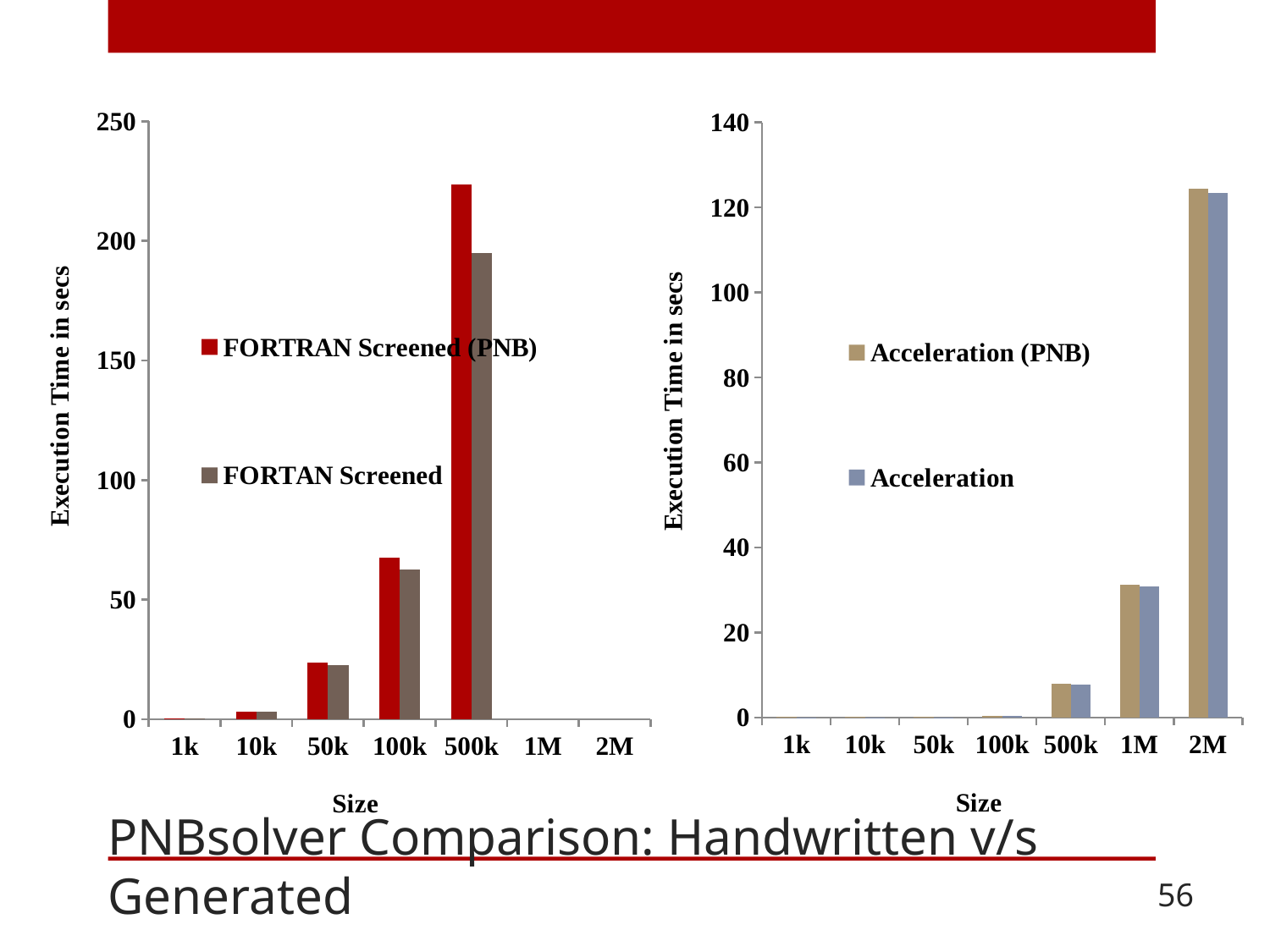
In the left chart, is the value for FORTAN Screened at size 500k greater or less than 150? greater In the left chart, which size has the highest execution time for FORTRAN Screened (PNB)? 500k How many size categories are shown on the x axis of the left chart? 7 What kind of chart is the left chart (FORTRAN Screened)? bar chart In the right chart, is the value for Acceleration (PNB) at size 2M greater or less than 120? greater In the right chart, which size has the highest execution time for Acceleration? 2M What is the y-axis label of the right chart? Execution Time in secs In the left chart, at size 500k, which series has the larger value: FORTRAN Screened (PNB) or FORTAN Screened? FORTRAN Screened (PNB) In the right chart, is the value for Acceleration at size 1M greater or less than 40? less How many series does the legend of the right chart (Acceleration) list? 2